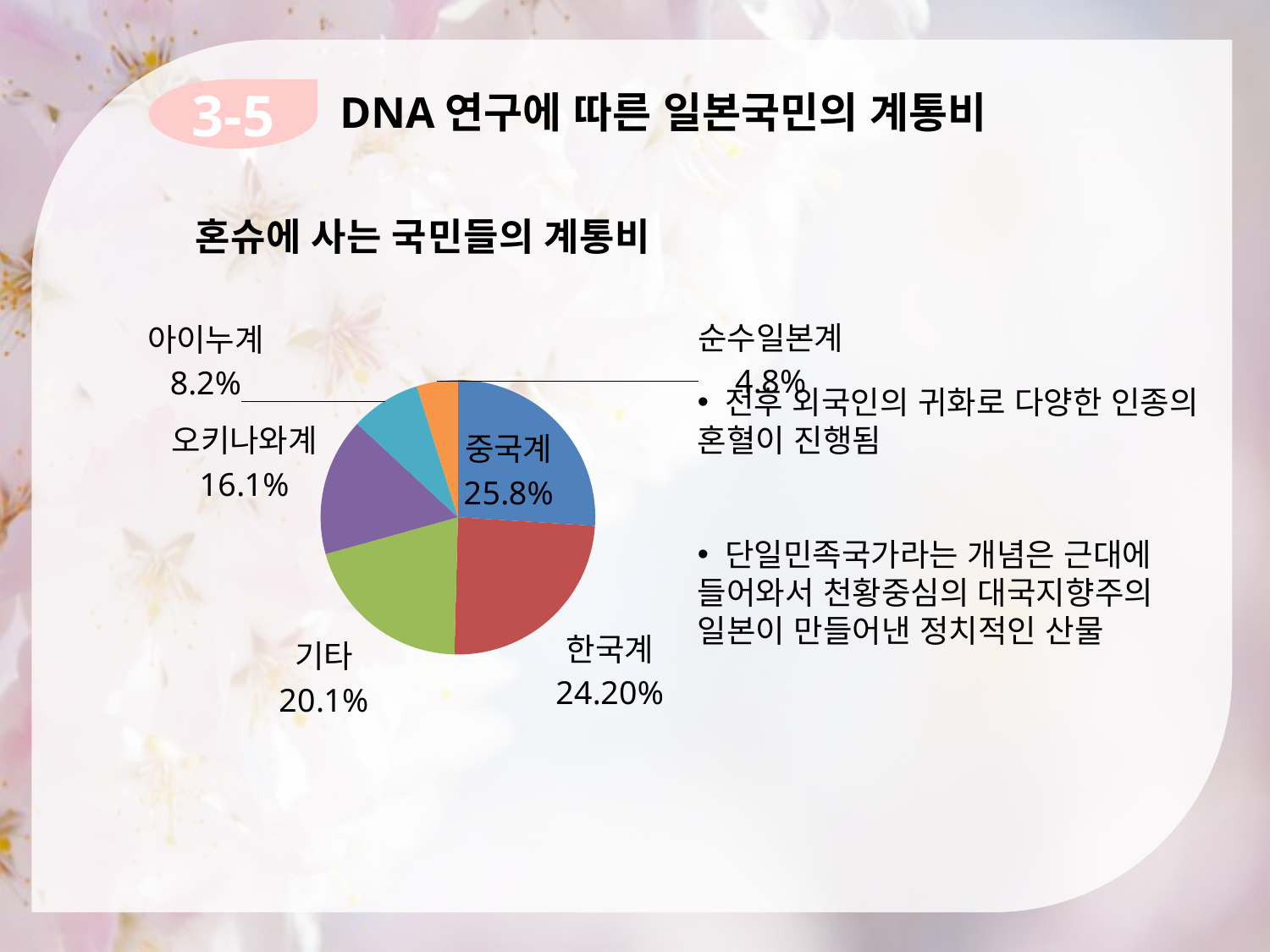
Which category has the smallest slice of the pie chart? 순수일본계 What is the value for 아이누계 in the pie chart? 8.2% What percentage is labelled for 오키나와계? 16.1% What is the title written above the pie chart? 혼슈에 사는 국민들의 계통비 By how many percentage points does 기타 exceed 오키나와계? 4.0 percentage points What percentage of the pie chart is 중국계? 25.8% Which is larger, the slice for 기타 or the slice for 오키나와계? 기타 Which category has the largest slice of the pie chart? 중국계 How many categories are shown in the pie chart? 6 What is the value shown for 기타 in the pie chart? 20.1% What type of chart is shown on the slide? Pie chart What share does 한국계 have in the pie chart? 24.20%